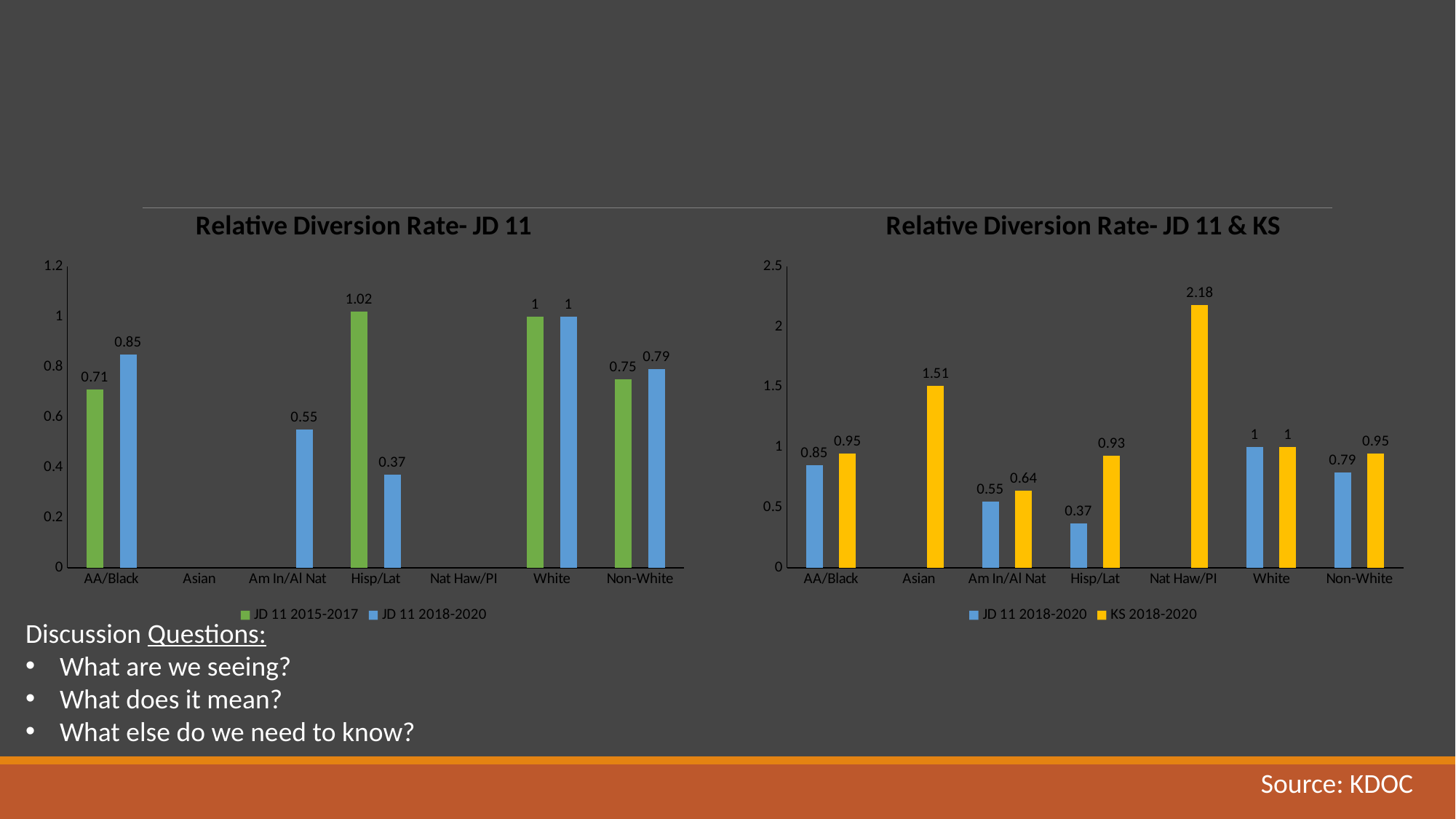
In the 'Relative Diversion Rate- JD 11' chart, what is the JD 11 2015-2017 value for Hisp/Lat? 1.02 In the 'Relative Diversion Rate- JD 11' chart, what is the JD 11 2018-2020 value for AA/Black? 0.85 In the 'Relative Diversion Rate- JD 11 & KS' chart, what is the KS 2018-2020 value for Nat Haw/PI? 2.18 In the 'Relative Diversion Rate- JD 11' chart, what is the difference between the JD 11 2015-2017 and JD 11 2018-2020 values for Hisp/Lat? 0.65 What type of chart is 'Relative Diversion Rate- JD 11 & KS'? Bar chart How many categories are shown on the x axis of the 'Relative Diversion Rate- JD 11 & KS' chart? 7 In the 'Relative Diversion Rate- JD 11 & KS' chart, what is the difference between the KS 2018-2020 and JD 11 2018-2020 values for Hisp/Lat? 0.56 In the 'Relative Diversion Rate- JD 11 & KS' chart, is the KS 2018-2020 value for Asian greater or less than 1? greater In the 'Relative Diversion Rate- JD 11' chart, how many series does the legend list? 2 In the 'Relative Diversion Rate- JD 11' chart, which category has the lowest JD 11 2018-2020 value among those with a labelled bar? Hisp/Lat In the 'Relative Diversion Rate- JD 11 & KS' chart, which category has the highest KS 2018-2020 value? Nat Haw/PI In the 'Relative Diversion Rate- JD 11 & KS' chart, which is larger for Am In/Al Nat: JD 11 2018-2020 or KS 2018-2020? KS 2018-2020